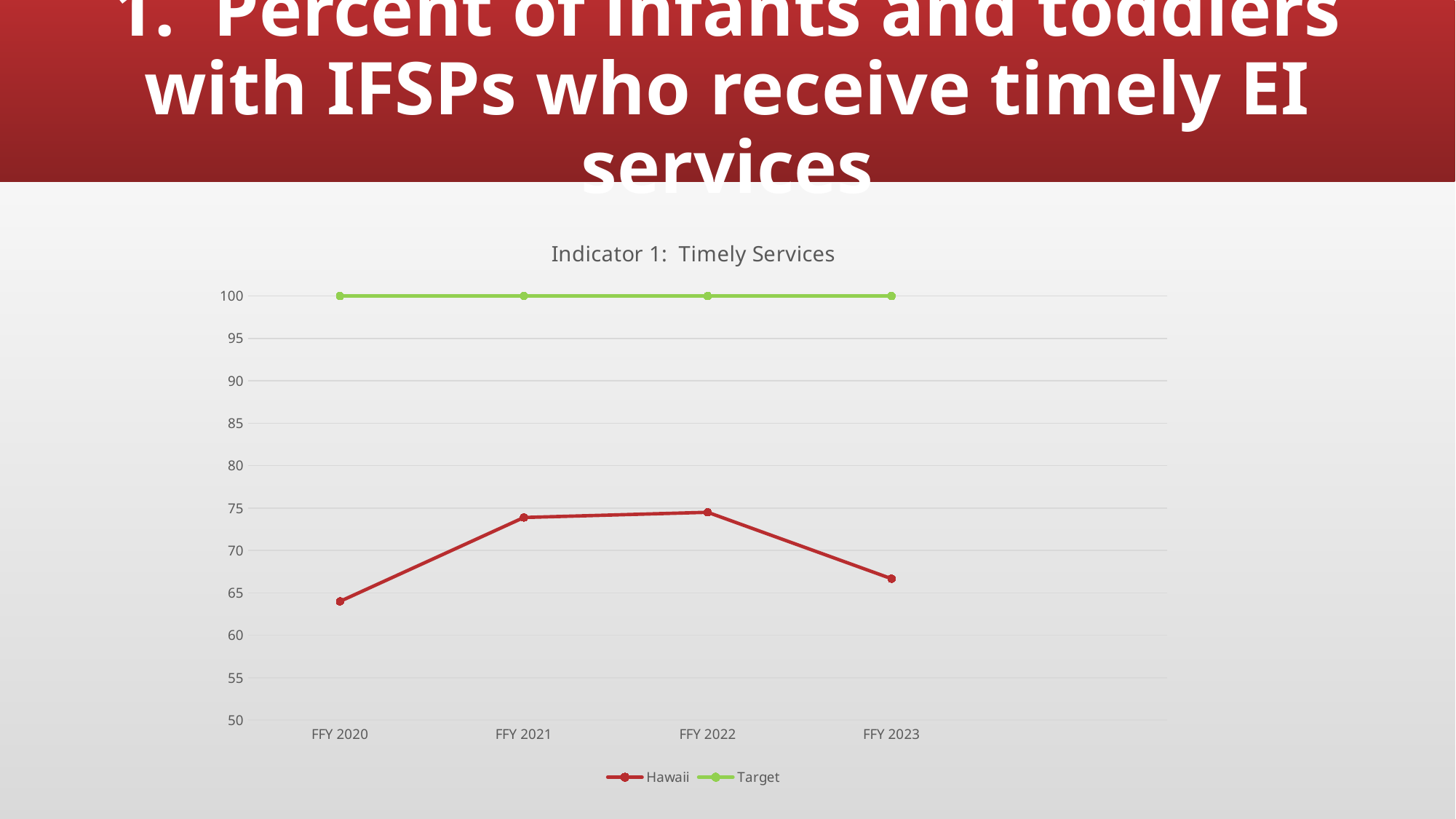
Is the Hawaii value for FFY 2021 greater or less than 70? greater How many series does the legend list? 2 What is the Target value for FFY 2023? 100 Is the Hawaii value for FFY 2020 greater or less than 65? less In which year is the Hawaii value lowest? FFY 2020 What is the title of the chart? Indicator 1: Timely Services Does the Hawaii line rise or fall from FFY 2022 to FFY 2023? fall Which is larger for Hawaii, the value for FFY 2020 or the value for FFY 2023? FFY 2023 How many FFY categories are shown on the x axis? 4 Is the Hawaii value for FFY 2023 greater or less than 70? less What type of chart is shown on the slide? line chart What is the Target value for FFY 2021? 100